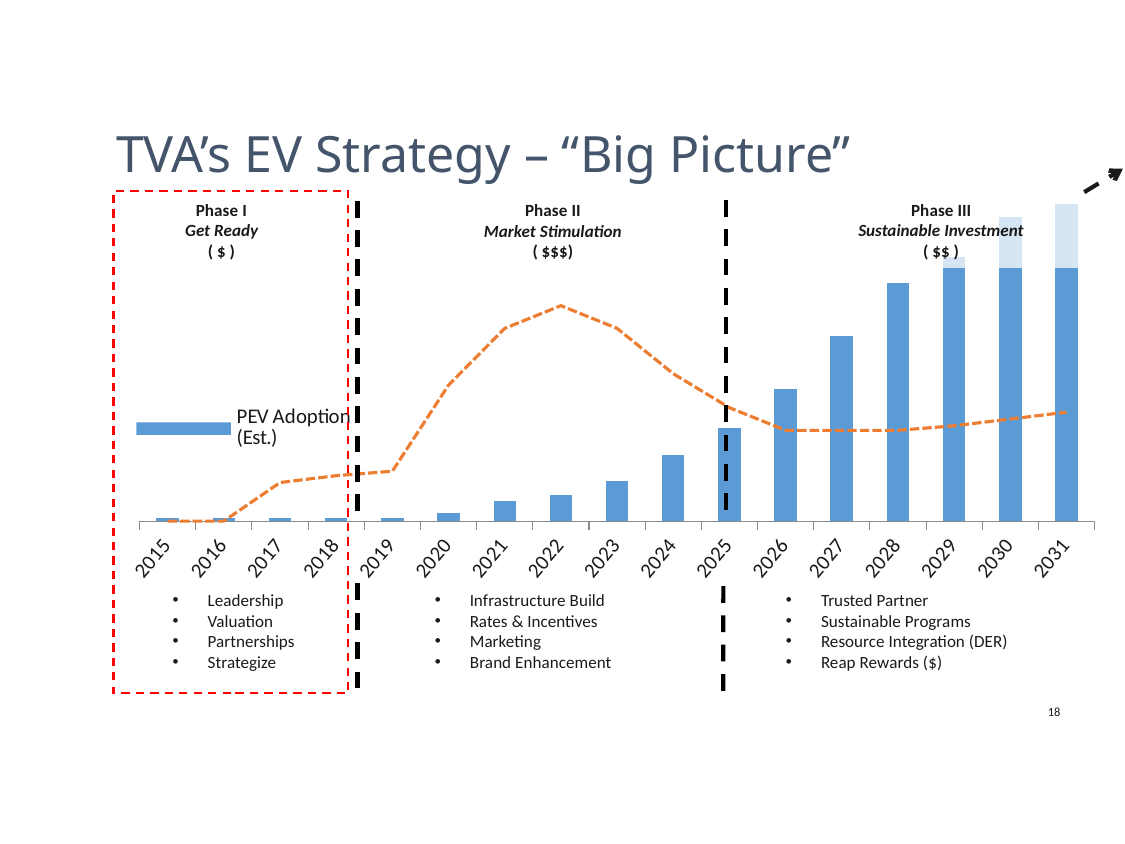
Is the bar for 2028 taller or shorter than the bar for 2024? taller How many phases is the chart divided into? 3 Which year has the tallest bar in the chart? 2031 Does the dashed orange line rise or fall between 2022 and 2025? fall What kind of chart is shown on the slide? combination bar and line chart In which year does the dashed orange line reach its peak? 2022 What is the last year shown on the x axis of the chart? 2031 What is the first year shown on the x axis of the chart? 2015 Do the bars generally rise or fall from 2015 to 2031? rise Is the bar for 2021 taller or shorter than the bar for 2026? shorter What does the blue bar in the legend represent? PEV Adoption (Est.) How many years are shown along the x axis of the chart? 17